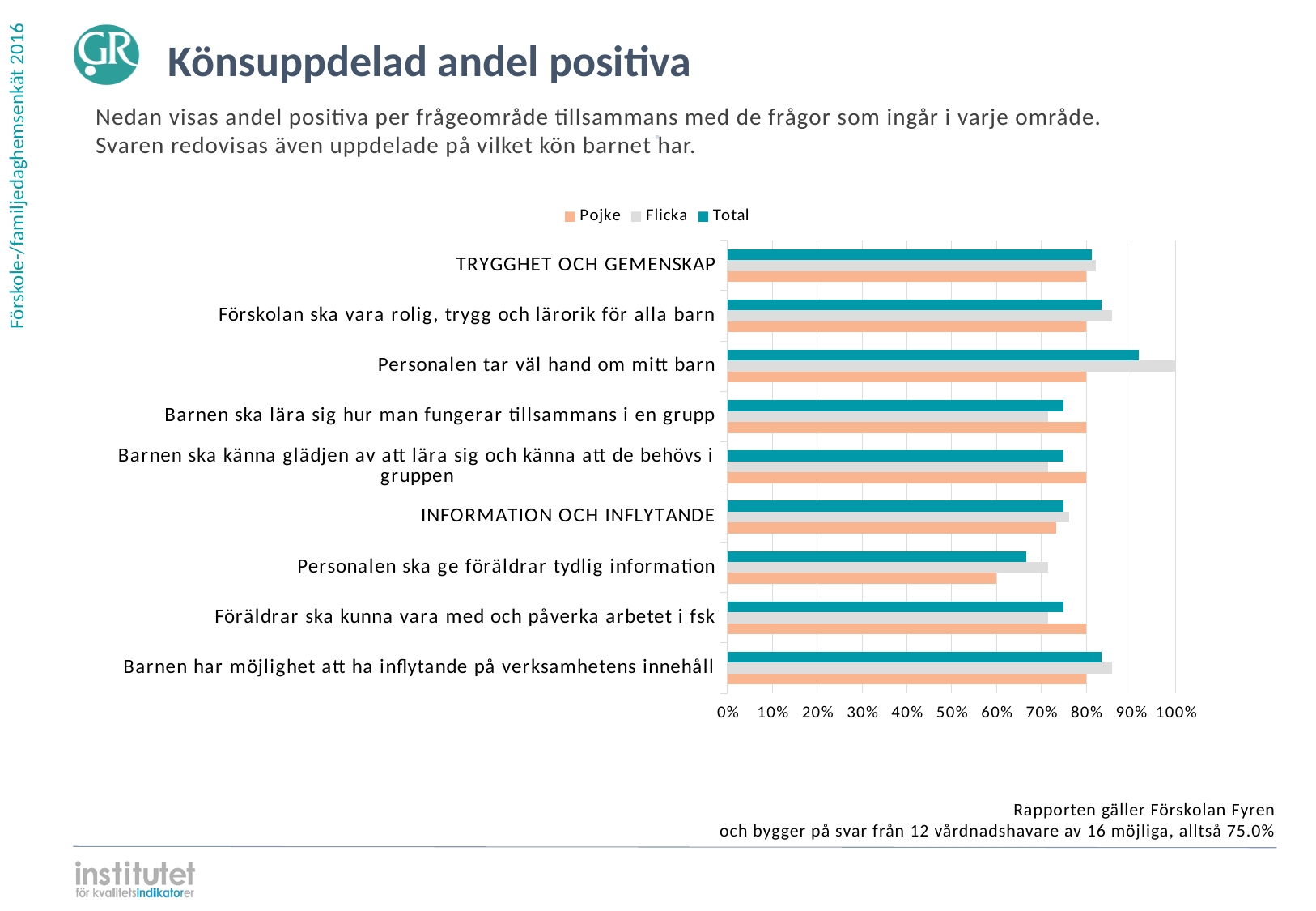
Which category has the highest Flicka value? Personalen tar väl hand om mitt barn What kind of chart is shown on the slide? bar chart Which category has the highest Total value? Personalen tar väl hand om mitt barn Which category has the lowest Pojke value? Personalen ska ge föräldrar tydlig information Is the Total value for 'Personalen tar väl hand om mitt barn' greater or less than 80%? greater Is the Pojke value for 'Personalen ska ge föräldrar tydlig information' greater or less than 70%? less How many series does the legend list? 3 For 'Personalen ska ge föräldrar tydlig information', which is larger: the Pojke value or the Flicka value? Flicka How many categories are plotted on the y axis of the chart? 9 Which category has the lowest Total value? Personalen ska ge föräldrar tydlig information For 'Personalen tar väl hand om mitt barn', which is larger: the Pojke value or the Flicka value? Flicka What are the three series named in the chart legend? Pojke, Flicka, Total